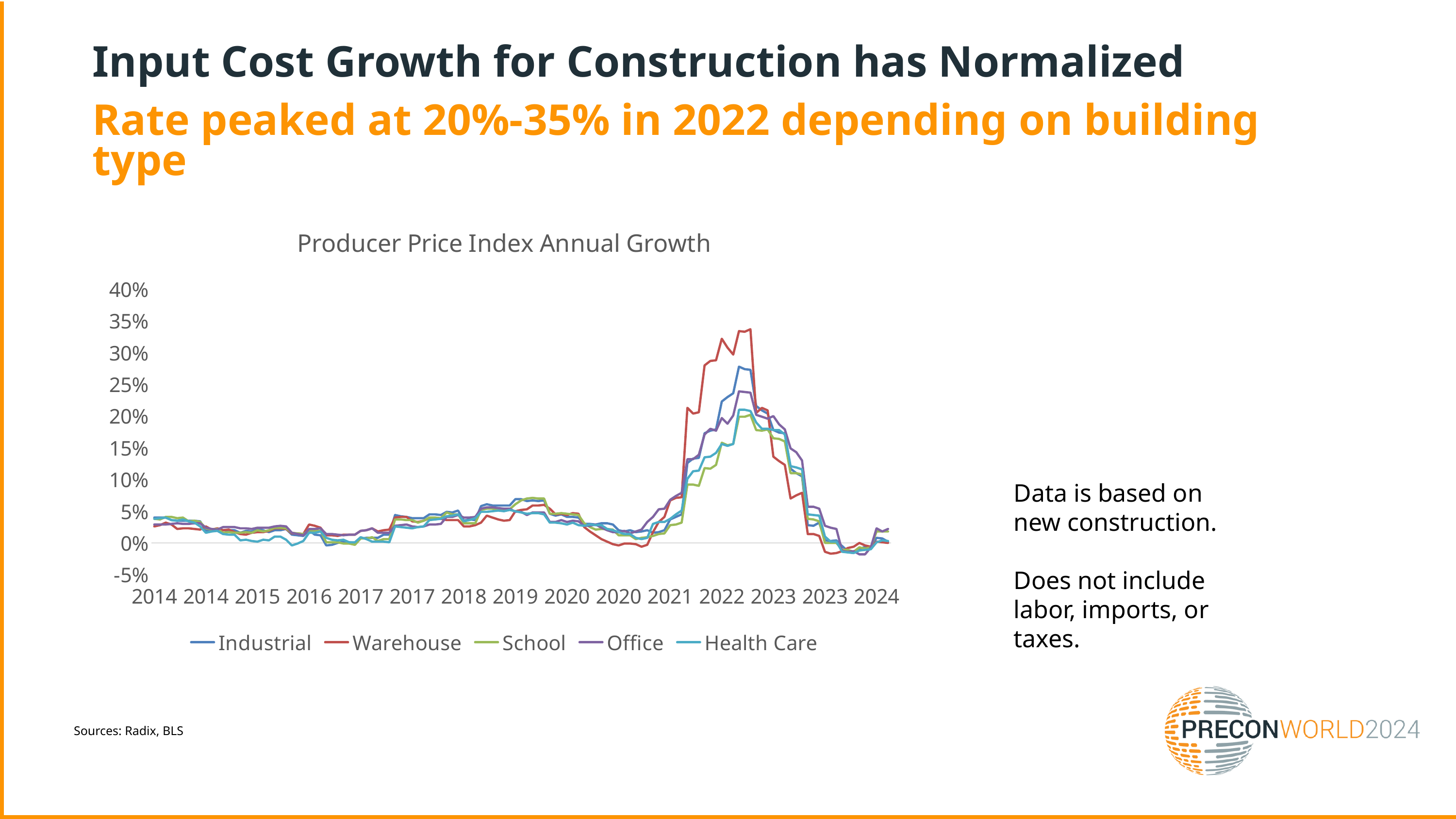
Is the peak value for Industrial greater or less than 25%? greater At their 2022 peaks, which series is higher, Industrial or Office? Industrial How many series does the chart's legend list? 5 What is the highest value shown on the y axis? 40% Is the peak value for Warehouse greater or less than 30%? greater Is the Warehouse value at the end of 2023 greater or less than 5%? less How many year labels are shown along the x axis? 15 Which series reaches the highest peak in the chart? Warehouse What is the title of the chart? Producer Price Index Annual Growth What kind of chart is shown on the slide? line chart Do the values rise or fall between the 2022 peak and 2024? fall